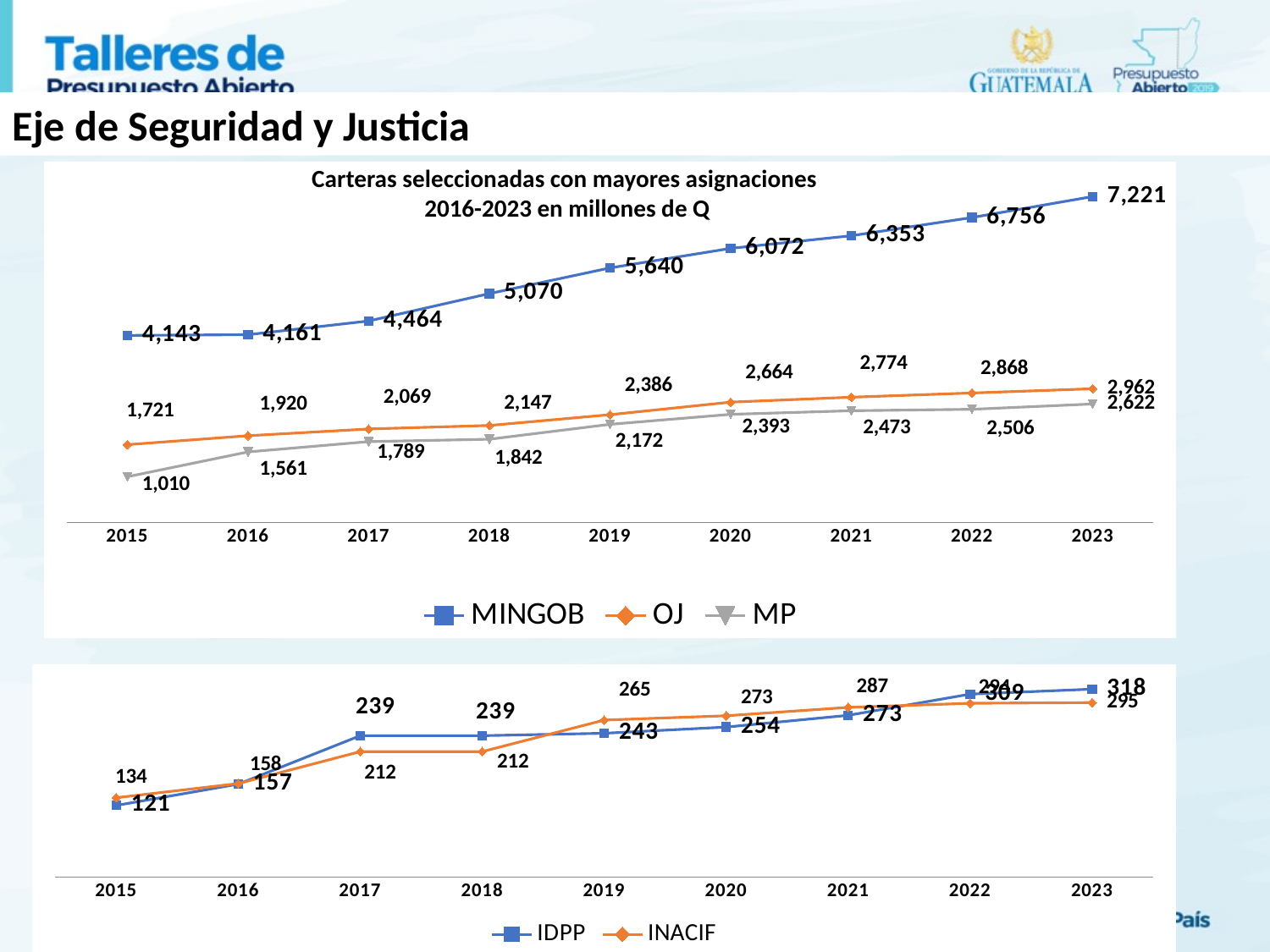
In the bottom chart, how many years are shown on the x axis? 9 In the top chart, what is the value for MP in 2015? 1,010 In the top chart, how many series does the legend list? 3 In the top chart, what is the difference between MINGOB and OJ in 2023? 4,259 In the bottom chart, what is the value for IDPP in 2015? 121 In the top chart, does the MINGOB series rise or fall from 2015 to 2023? rise In the top chart, which series has the highest values across all years? MINGOB In the top chart, what is the value for OJ in 2019? 2,386 In the top chart (Carteras seleccionadas con mayores asignaciones), what is the value for MINGOB in 2023? 7,221 What type of chart is the bottom chart? line chart In the bottom chart, what is the value for INACIF in 2021? 287 In the bottom chart, which is larger in 2019, IDPP or INACIF? INACIF